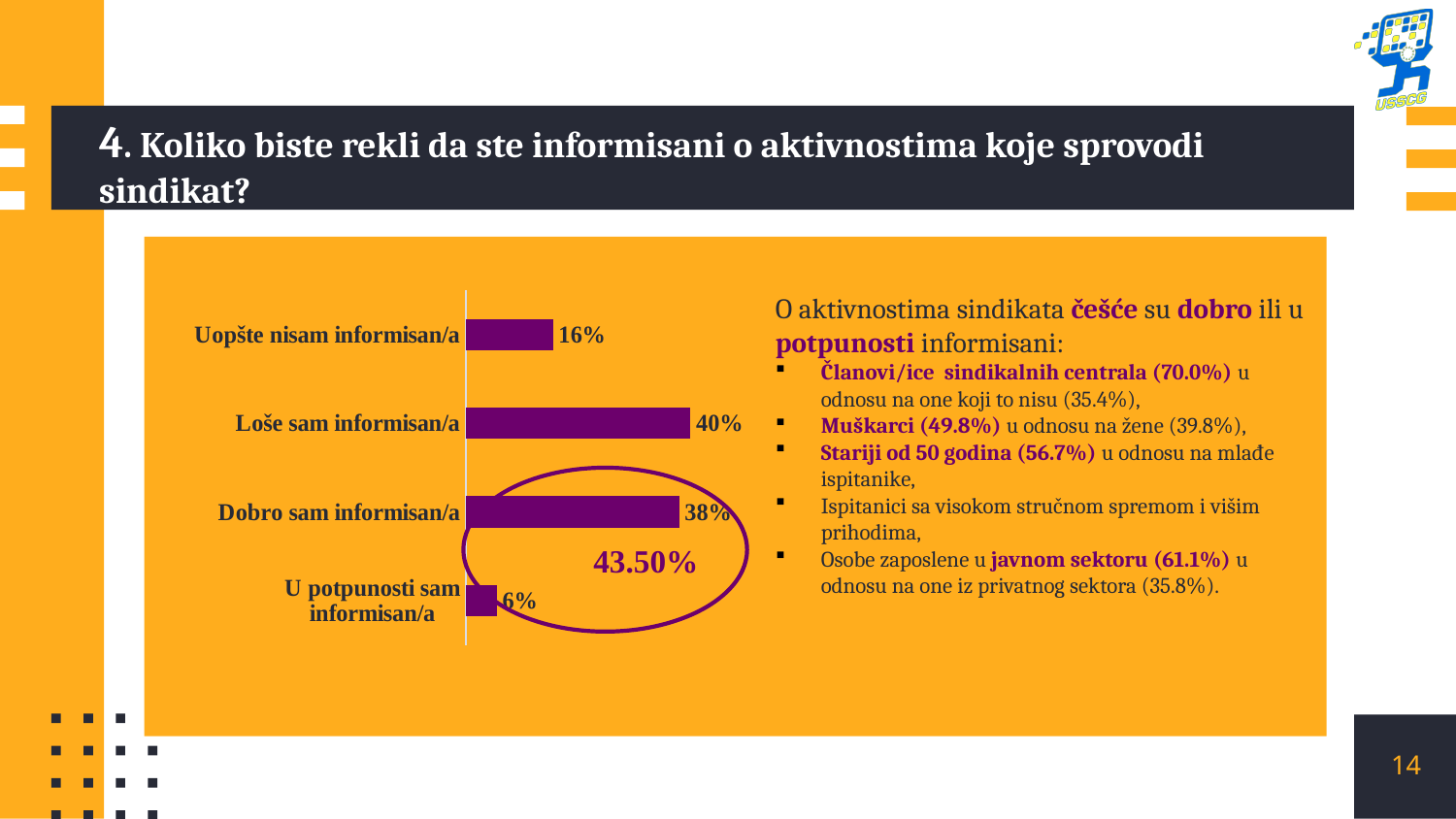
What percentage is written inside the circled annotation on the chart? 43.50% What is the difference in percentage points between "Loše sam informisan/a" and "Dobro sam informisan/a"? 2 percentage points Which response category has the highest percentage? Loše sam informisan/a What is the value shown for "Uopšte nisam informisan/a"? 16% How many response categories are shown in the chart? 4 What type of chart is used on the slide? Bar chart Which is larger: the value for "Dobro sam informisan/a" or for "Uopšte nisam informisan/a"? Dobro sam informisan/a What is the difference between "Loše sam informisan/a" and "Uopšte nisam informisan/a"? 24 percentage points What percentage of respondents answered "Loše sam informisan/a"? 40% Which response category has the lowest percentage? U potpunosti sam informisan/a What percentage is shown for "U potpunosti sam informisan/a"? 6% What is the value for "Dobro sam informisan/a"? 38%